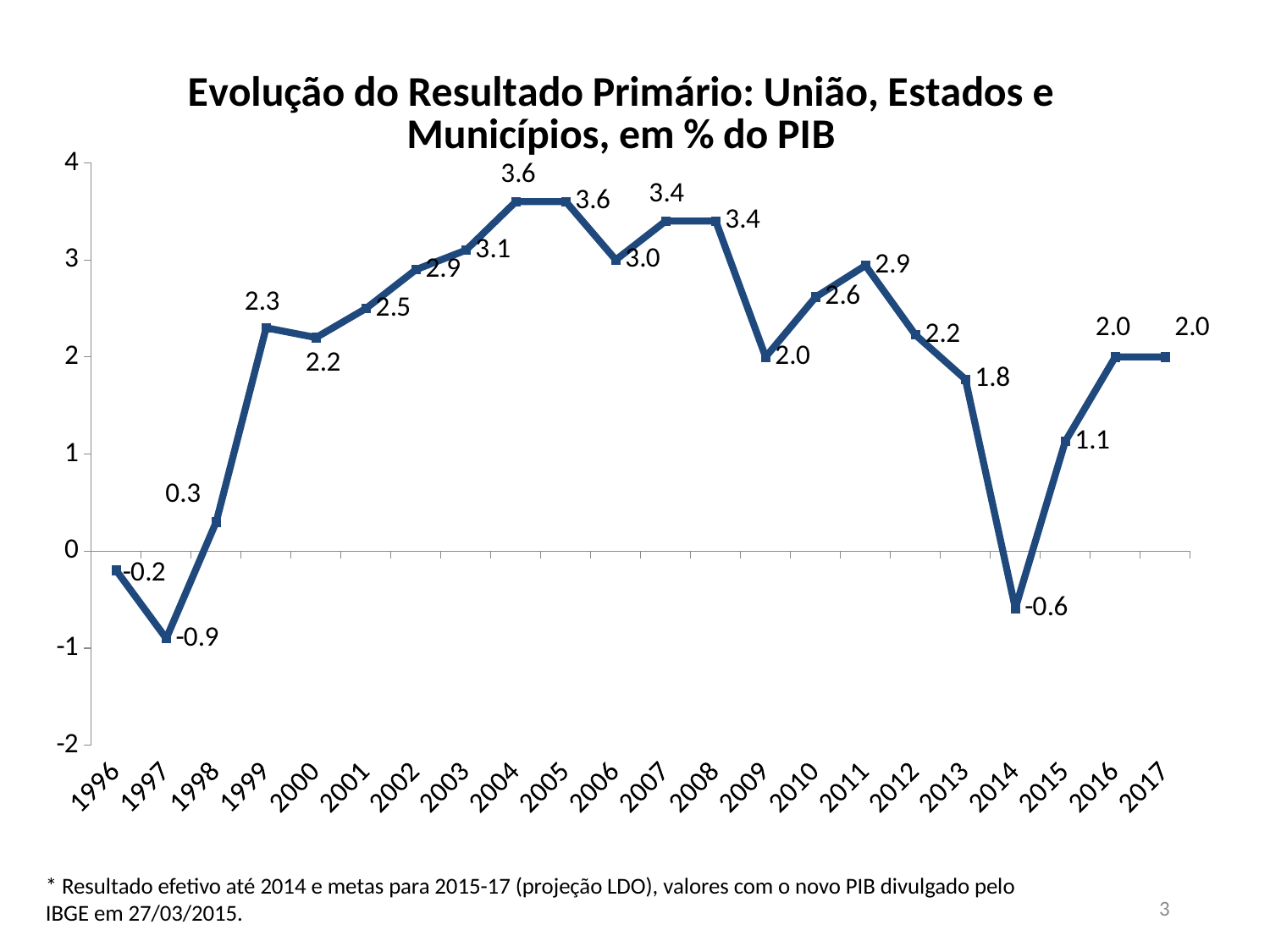
Do the values rise or fall from 2011 to 2014? fall What is the value for 2010? 2.6 What is the value for 2004? 3.6 What is the value for 1997? -0.9 What is the difference between the values for 2013 and 2014? 2.4 What type of chart is shown on the slide? line chart What is the difference between the values for 2005 and 2006? 0.6 What is the title of the chart? Evolução do Resultado Primário: União, Estados e Municípios, em % do PIB Which year has the lowest value? 1997 How many years are plotted on the x axis? 22 Which is larger, the value for 2011 or the value for 2012? 2011 What is the value for 2014? -0.6